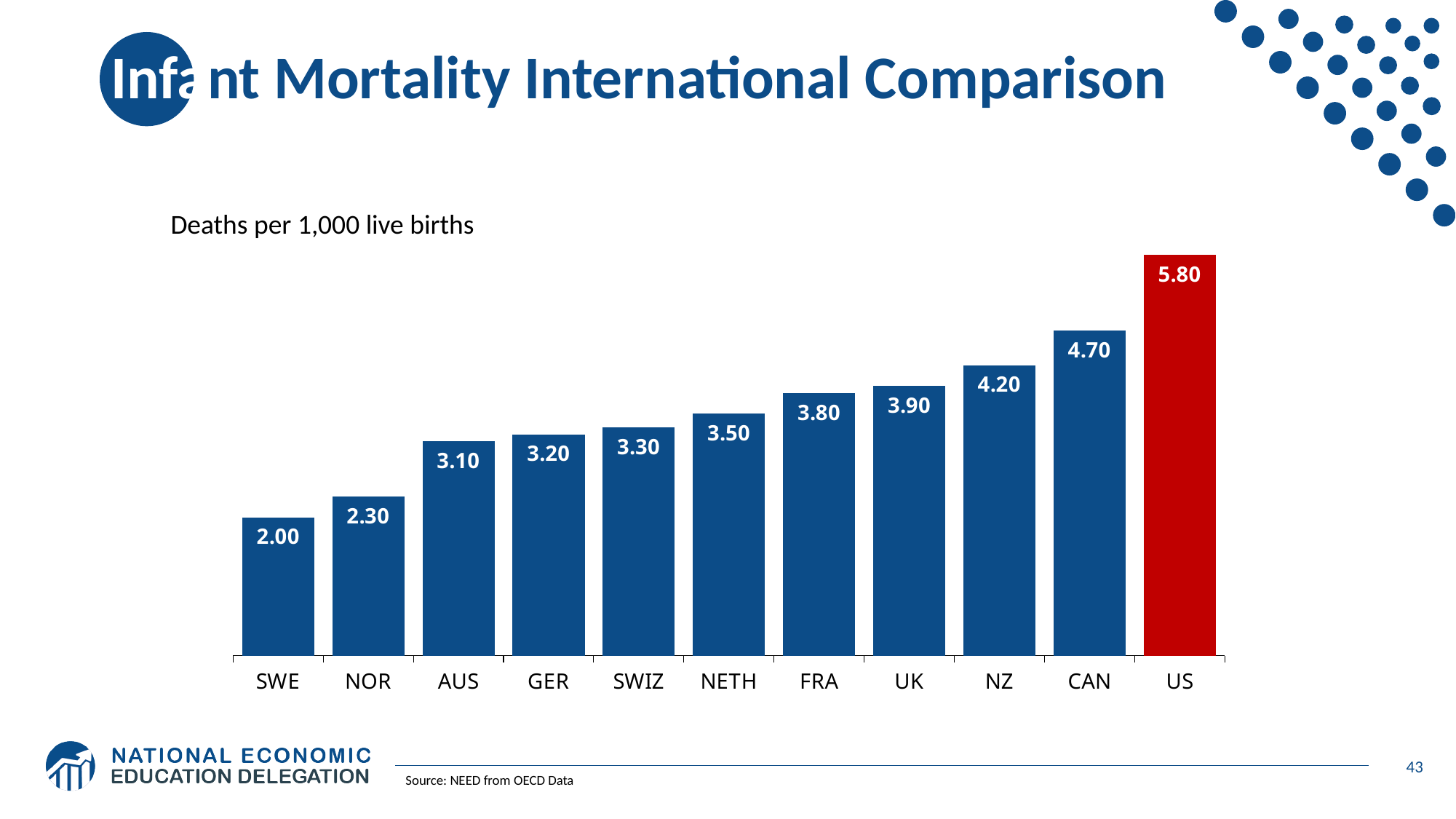
What is the difference between the values for the US and CAN? 1.10 Do the values rise or fall from left to right across the chart? Rise What is the difference between the values for NOR and SWE? 0.30 What is the infant mortality value shown for the US? 5.80 What kind of chart is shown on the slide? Bar chart What is the value shown for NETH? 3.50 Which bar is coloured red rather than blue? US What is the value shown for SWE? 2.00 Which has a higher value, UK or FRA? UK How many countries are shown on the chart? 11 Which country has the highest infant mortality rate on the chart? US Which country has the lowest infant mortality rate on the chart? SWE